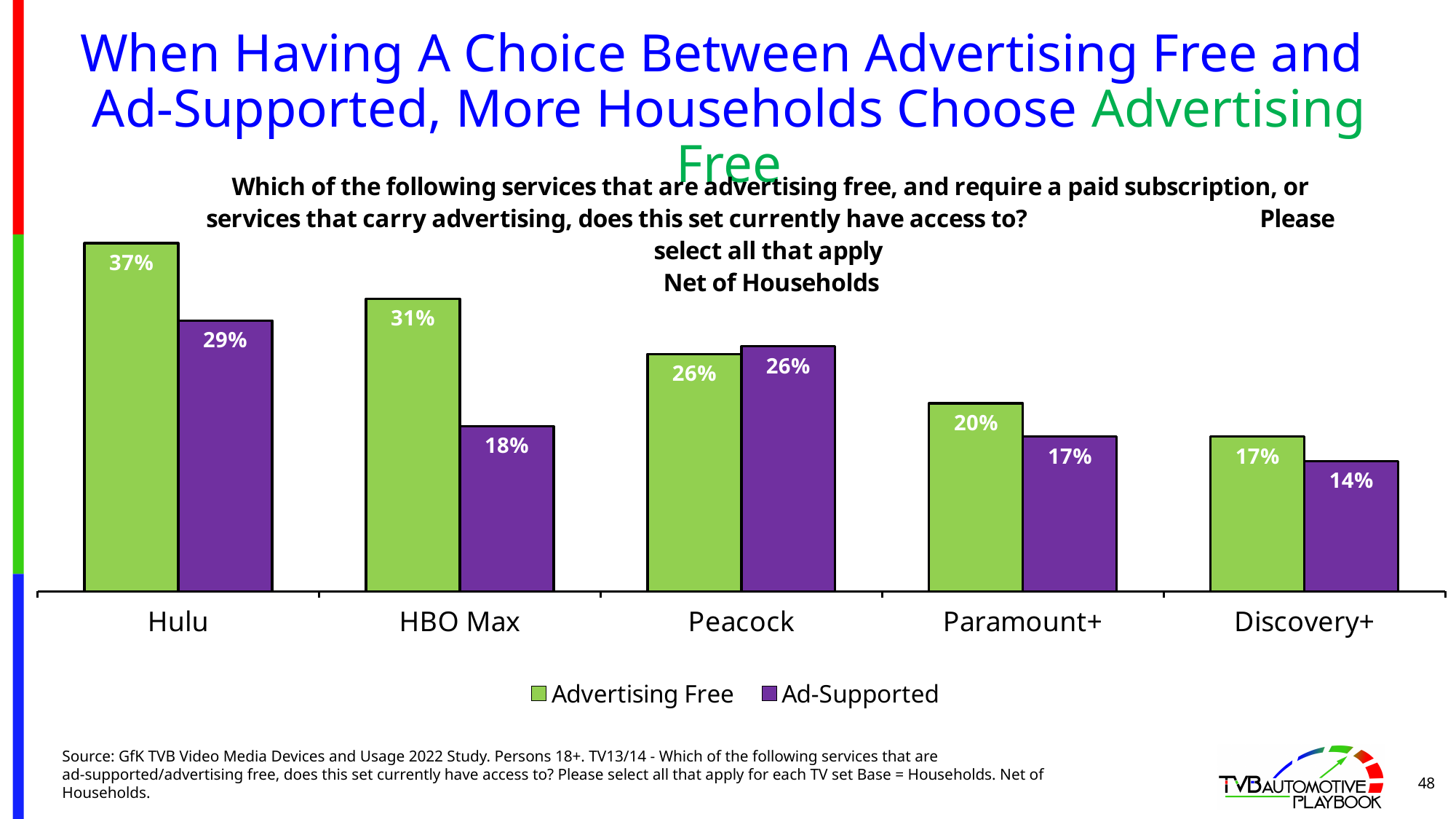
What is the difference between the Advertising Free and Ad-Supported values for HBO Max? 13% What is the difference between the Advertising Free values for Hulu and Paramount+? 17% Which is larger for Paramount+: the Advertising Free value or the Ad-Supported value? Advertising Free Which service has the highest Advertising Free value? Hulu Which service has the lowest Ad-Supported value? Discovery+ What is the Ad-Supported value for HBO Max? 18% What kind of chart is shown on the slide? Bar chart Which colour represents the Ad-Supported series? Purple What is the Ad-Supported value for Discovery+? 14% What is the Advertising Free value for Hulu? 37% How many series does the legend list? 2 How many services are shown on the x axis? 5